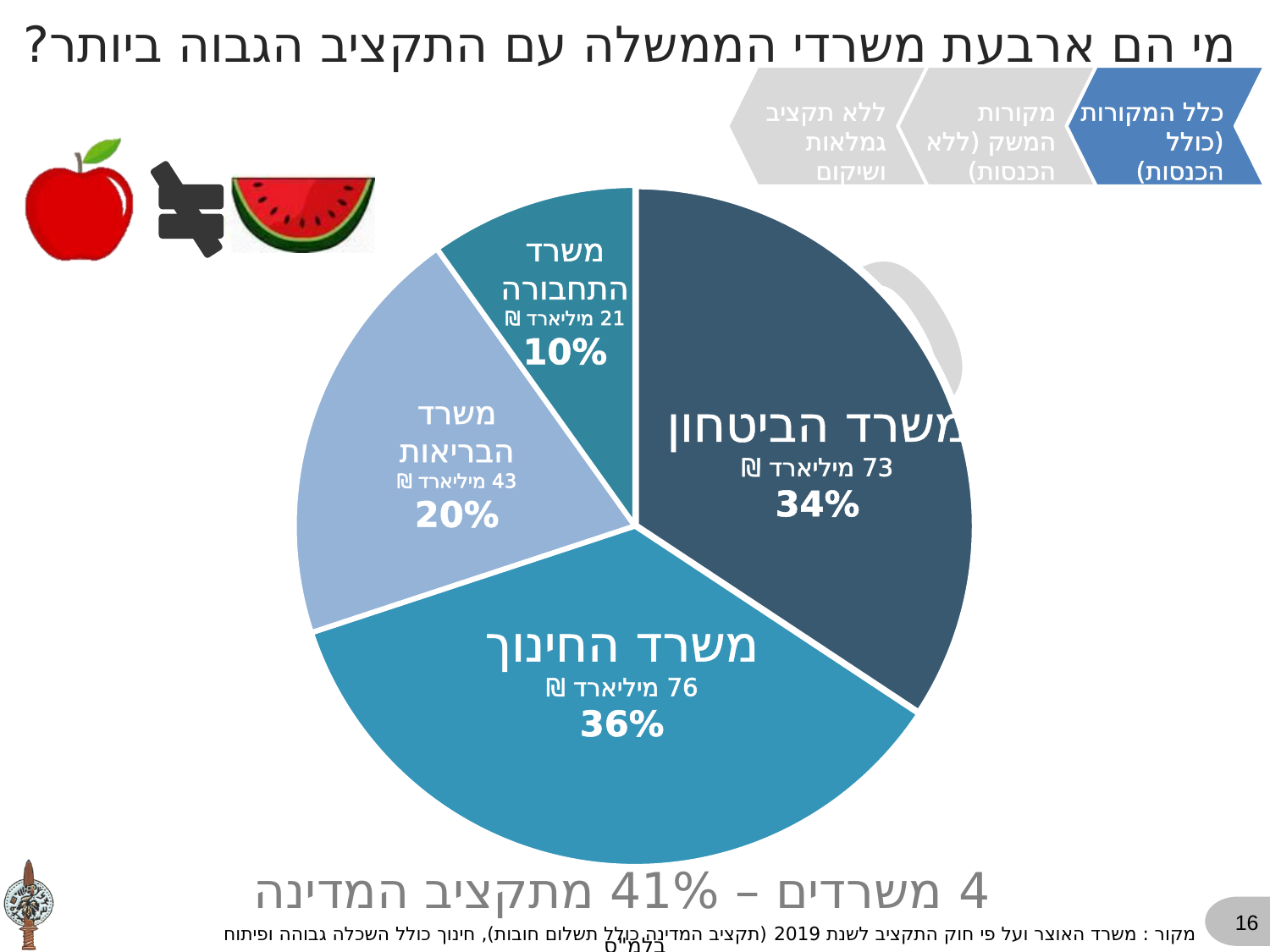
What is the difference in percentage points between משרד הבריאות and משרד התחבורה? 10 What value in billions of ₪ is shown for משרד הביטחון? 73 מיליארד ₪ What is the title of the slide containing the pie chart? מי הם ארבעת משרדי הממשלה עם התקציב הגבוה ביותר? Which ministry has the largest slice of the pie chart? משרד החינוך What kind of chart is shown on the slide? pie chart What percentage share is shown for משרד הבריאות? 20% What percentage share is shown for משרד החינוך? 36% Which ministry has the smallest slice of the pie chart? משרד התחבורה Which is larger, the share of משרד הבריאות or the share of משרד התחבורה? משרד הבריאות What value in billions of ₪ is shown for משרד התחבורה? 21 מיליארד ₪ What is the difference in billions of ₪ between משרד החינוך and משרד הביטחון? 3 מיליארד ₪ How many slices does the pie chart have? 4